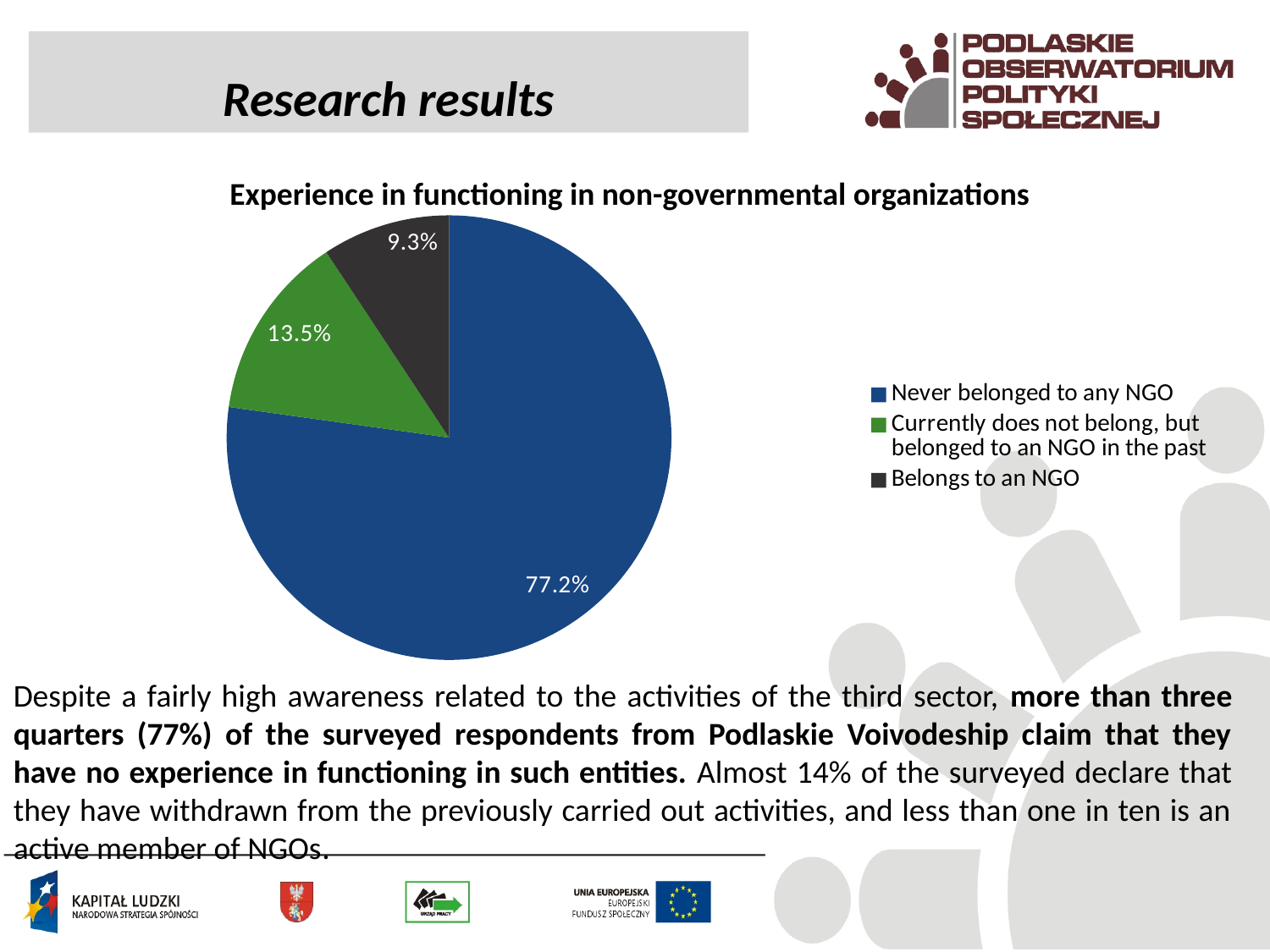
What is the title of the chart? Experience in functioning in non-governmental organizations Which category has the smallest share of the pie? Belongs to an NGO What percentage of respondents belong to an NGO? 9.3% What is the difference in percentage points between 'Currently does not belong, but belonged to an NGO in the past' and 'Belongs to an NGO'? 4.2 Which category has the largest share of the pie? Never belonged to any NGO What kind of chart is shown on the slide? pie chart What percentage of respondents currently do not belong, but belonged to an NGO in the past? 13.5% What colour is the slice for 'Belongs to an NGO'? dark grey Which is larger: the share for 'Currently does not belong, but belonged to an NGO in the past' or the share for 'Belongs to an NGO'? Currently does not belong, but belonged to an NGO in the past What is the difference in percentage points between 'Never belonged to any NGO' and 'Belongs to an NGO'? 67.9 How many categories does the legend list? 3 What percentage of respondents never belonged to any NGO? 77.2%